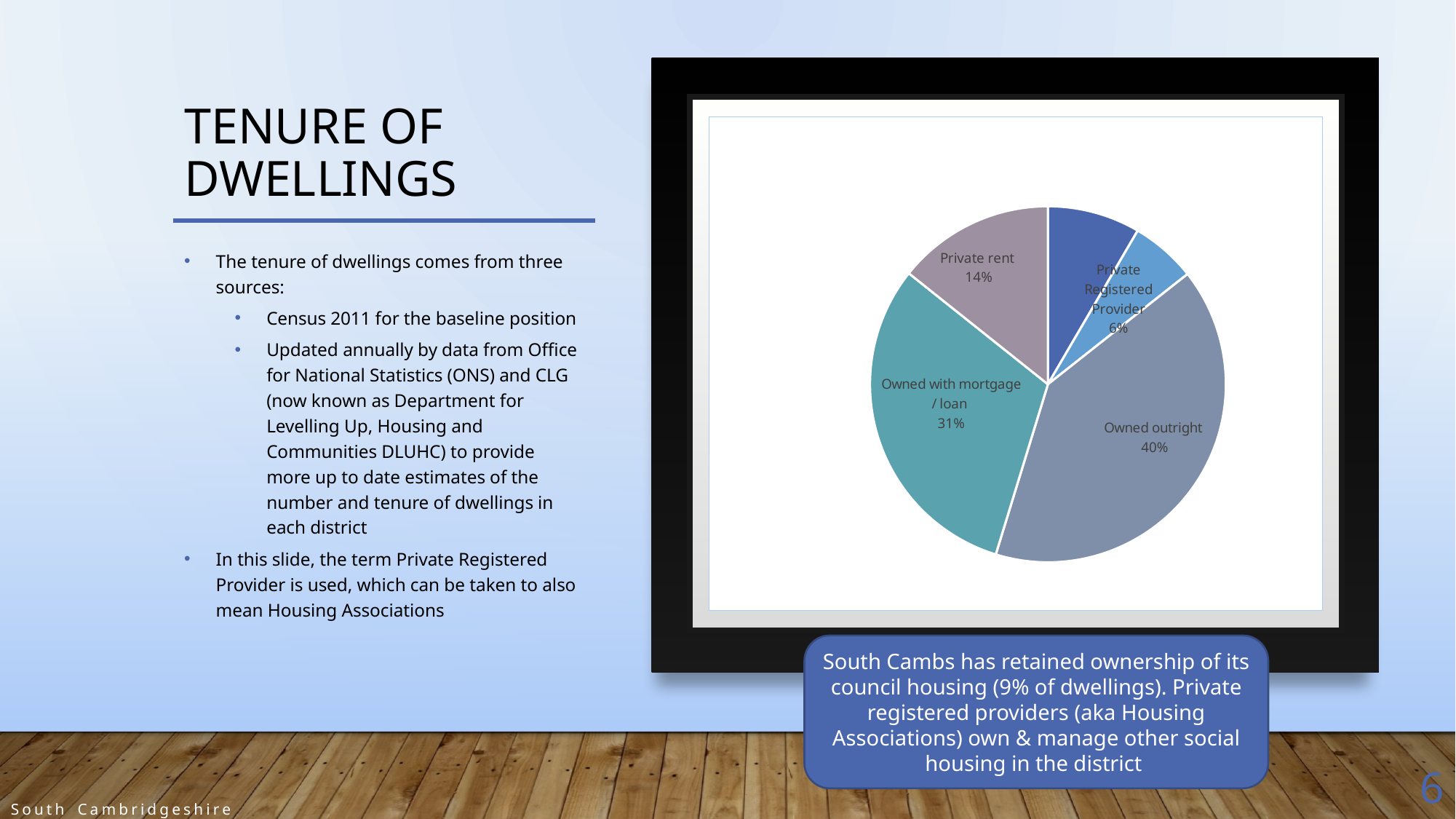
Which labelled tenure category has the largest share of the pie? Owned outright What kind of chart is shown on the slide? Pie chart Which is larger, the share for Private rent or the share for Private Registered Provider? Private rent What share of dwellings is Private rent? 14% What share of dwellings is Private Registered Provider? 6% What is the difference in percentage points between Private rent and Private Registered Provider? 8 What is the difference in percentage points between Owned outright and Owned with mortgage / loan? 9 What share of dwellings is Owned with mortgage / loan? 31% What share of dwellings is Owned outright? 40% What is the combined share of Owned outright and Owned with mortgage / loan? 71% How many slices does the pie chart have? 5 Which labelled tenure category has the smallest share of the pie? Private Registered Provider